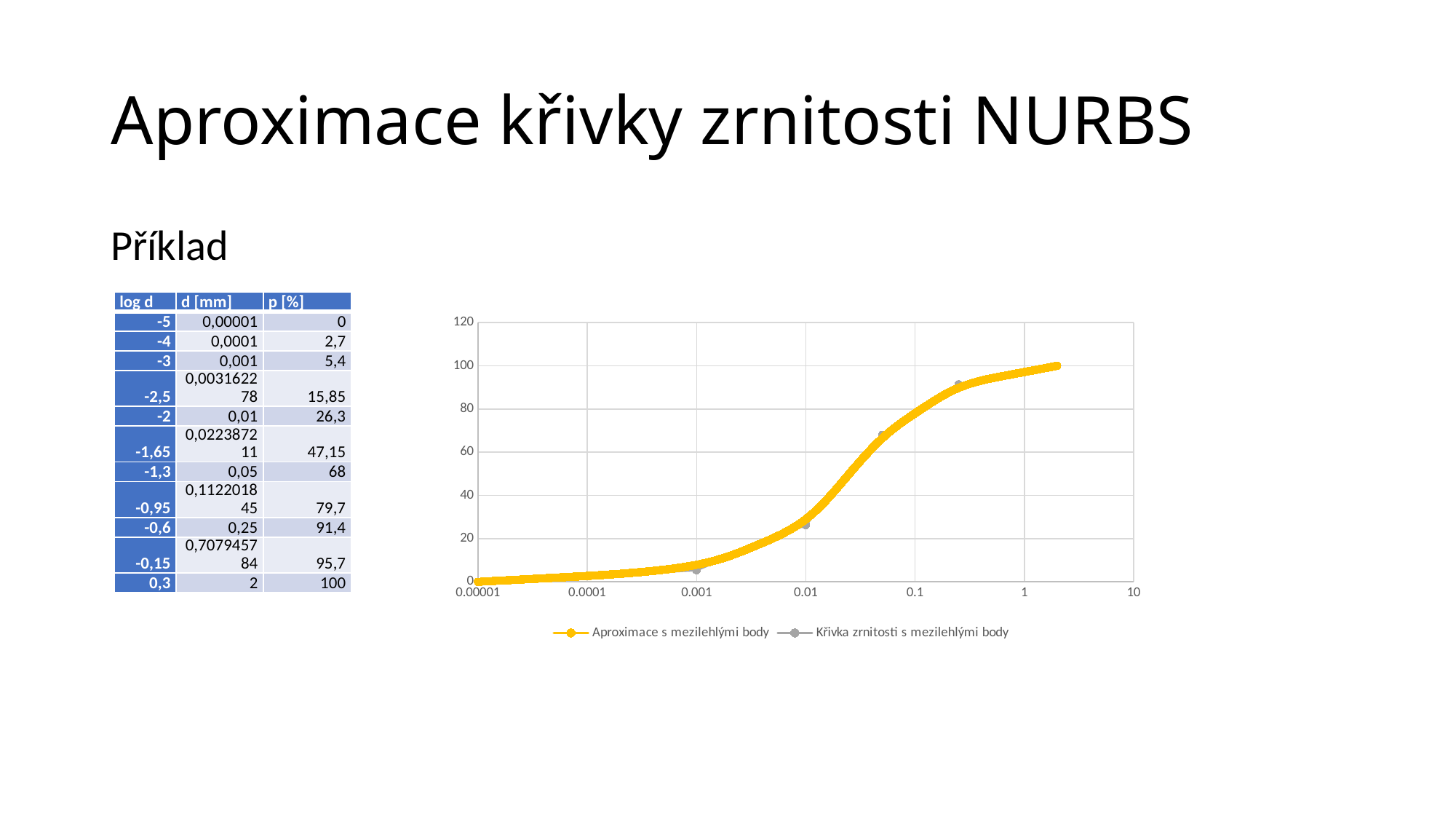
Is the value of the grey 'Křivka zrnitosti s mezilehlými body' point at x = 0.01 greater or less than 40? less What kind of chart is shown on the slide? line chart Is the value of the grey 'Křivka zrnitosti s mezilehlými body' point at x = 0.05 greater or less than 60? greater Is the value of the grey 'Křivka zrnitosti s mezilehlými body' point at x = 0.25 greater or less than 80? greater What value does the yellow approximation curve reach at its right-hand end (x = 2)? 100 What are the two series named in the chart legend? Aproximace s mezilehlými body; Křivka zrnitosti s mezilehlými body Do the values of the curve rise or fall as you move from left to right along the x axis? rise What is the highest value shown on the chart's vertical axis? 120 What value does the yellow approximation curve have at its left-hand end (x = 0.00001)? 0 Which colour is used for the series 'Aproximace s mezilehlými body'? yellow How many series does the chart legend list? 2